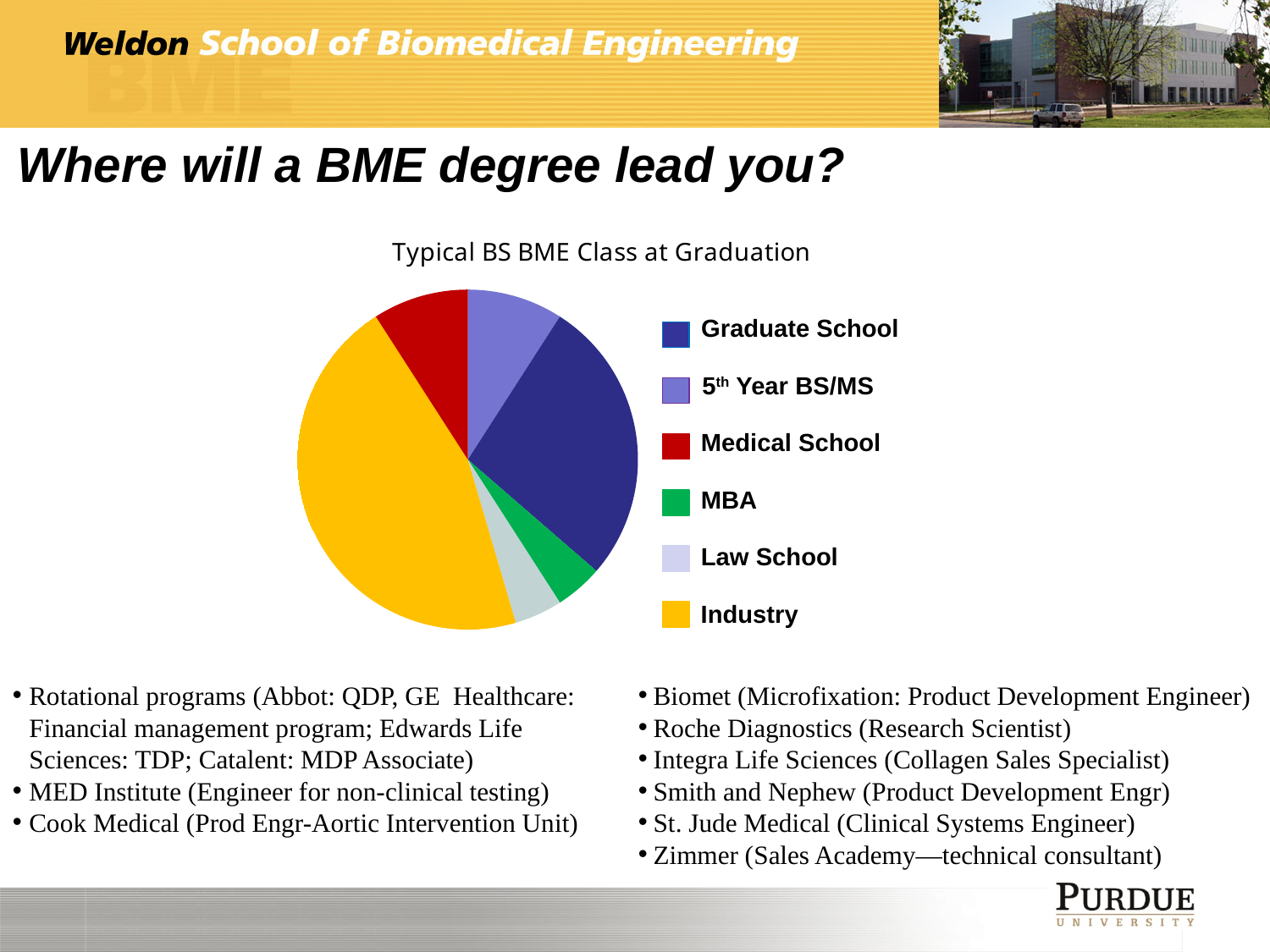
Which slice is larger, Industry or MBA? Industry Which category has the largest slice of the pie chart? Industry Which slice is larger, Industry or Graduate School? Industry What is the title of the pie chart? Typical BS BME Class at Graduation Which slice is larger, Medical School or Law School? Medical School Which category is the second-largest slice of the pie chart? Graduate School How many categories does the pie chart show? 6 What colour is the Industry slice in the pie chart? Yellow What kind of chart is shown on the slide? Pie chart